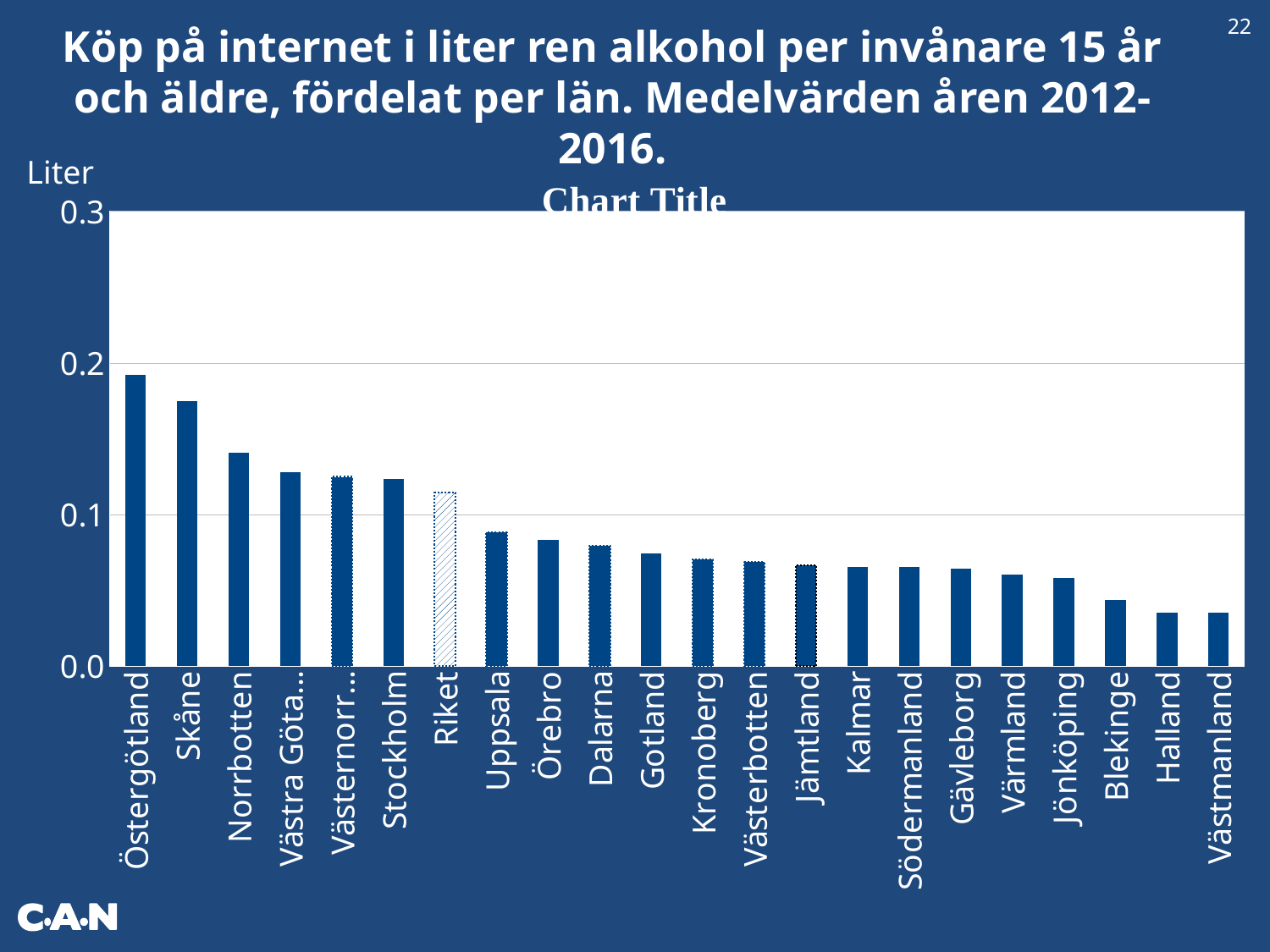
What unit label is shown above the vertical axis? Liter Is the value for Skåne greater or less than 0.2? less Is the value for Blekinge greater or less than 0.1? less Is the value for Östergötland greater or less than 0.1? greater Which category has the highest value? Östergötland What kind of chart is shown on the slide? bar chart Do the values generally rise or fall moving from left to right along the x axis? fall Which is larger, the value for Östergötland or the value for Skåne? Östergötland How many counties/categories are plotted along the x axis? 22 Which is larger, the value for Norrbotten or the value for Uppsala? Norrbotten